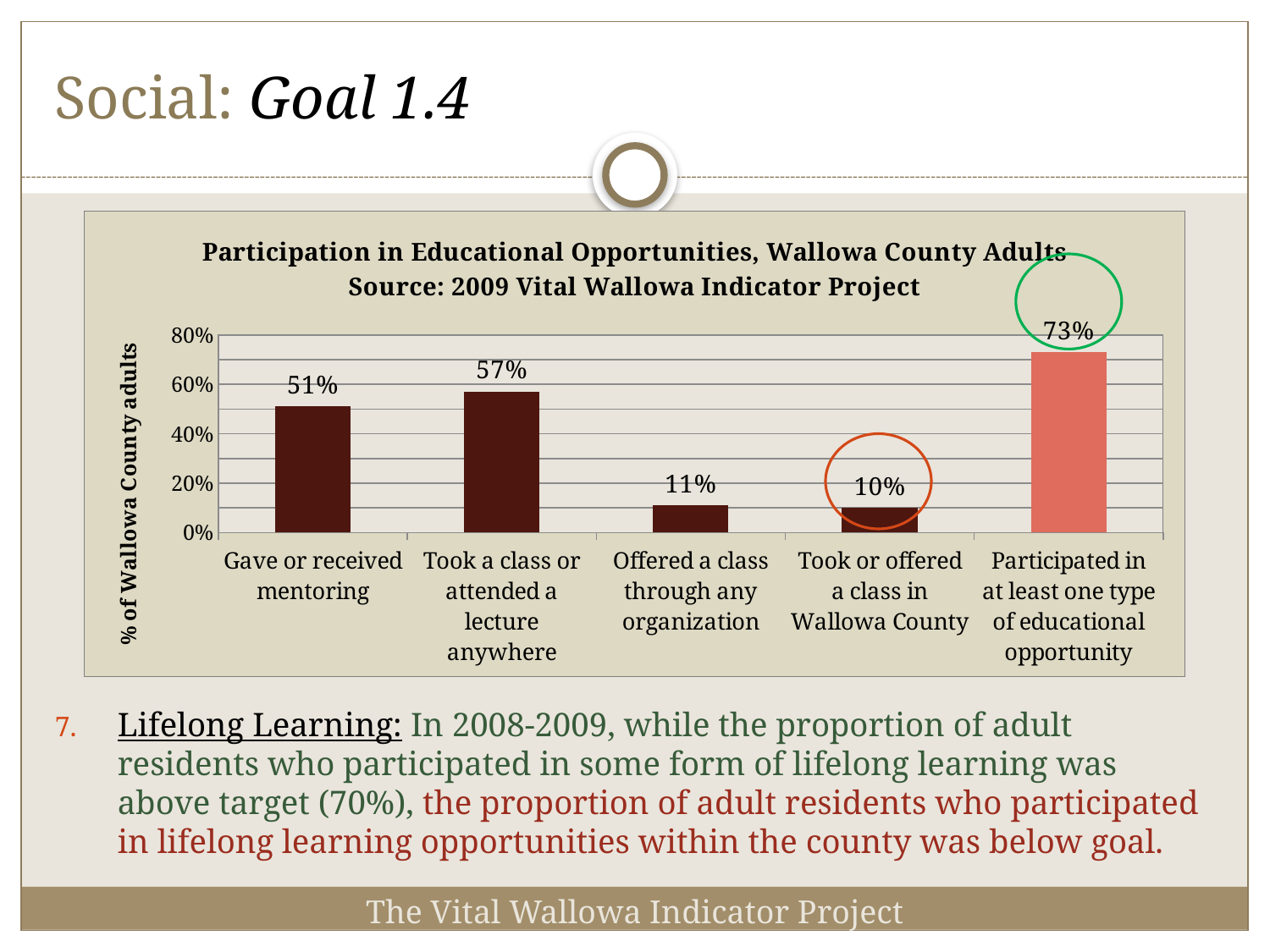
Which is larger: 'Gave or received mentoring' or 'Offered a class through any organization'? Gave or received mentoring Is the value for 'Offered a class through any organization' greater or less than 20%? less What is the value for 'Took a class or attended a lecture anywhere'? 57% What source is cited in the chart title? 2009 Vital Wallowa Indicator Project What is the difference between 'Participated in at least one type of educational opportunity' and 'Took a class or attended a lecture anywhere'? 16% Which category has the lowest value in the chart? Took or offered a class in Wallowa County What percentage of adults took or offered a class in Wallowa County? 10% What percentage of Wallowa County adults gave or received mentoring? 51% What type of chart is shown on the slide? Bar chart How many categories are shown in the chart? 5 What is the label of the vertical axis of the chart? % of Wallowa County adults Which category has the highest value in the chart? Participated in at least one type of educational opportunity